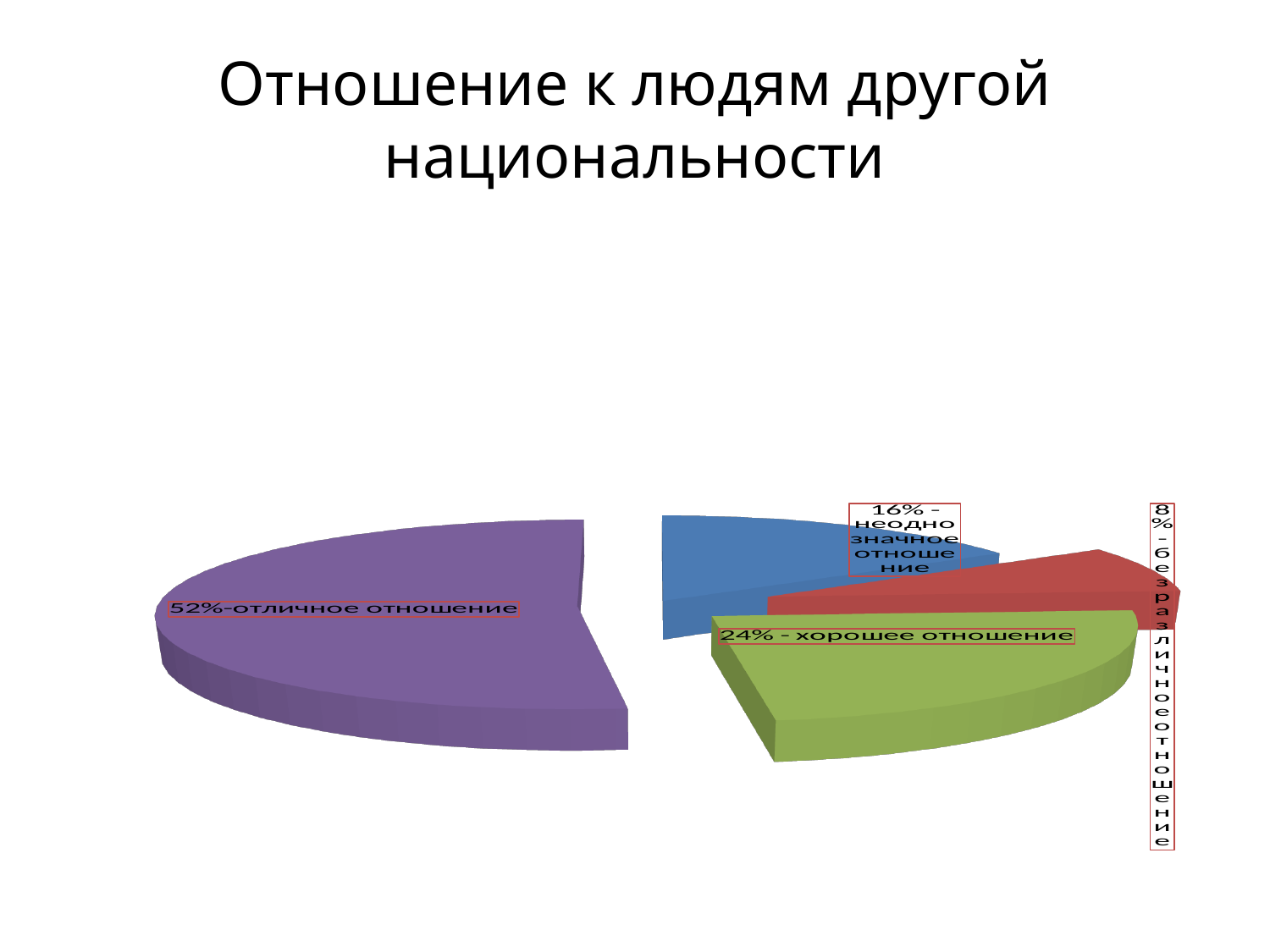
How many slices does the pie chart have? 4 What is the title of the chart on the slide? Отношение к людям другой национальности Which category has the largest share of the pie? отличное отношение What is the difference in percentage points between "отличное отношение" and "хорошее отношение"? 28 What share of the pie is labelled "неоднозначное отношение"? 16% What colour is the slice for "отличное отношение"? purple What share of the pie is labelled "хорошее отношение"? 24% What share of the pie is labelled "отличное отношение"? 52% Which is larger: the share for "хорошее отношение" or the share for "неоднозначное отношение"? хорошее отношение What kind of chart is shown on the slide? pie chart Which category has the smallest share of the pie? безразличное отношение